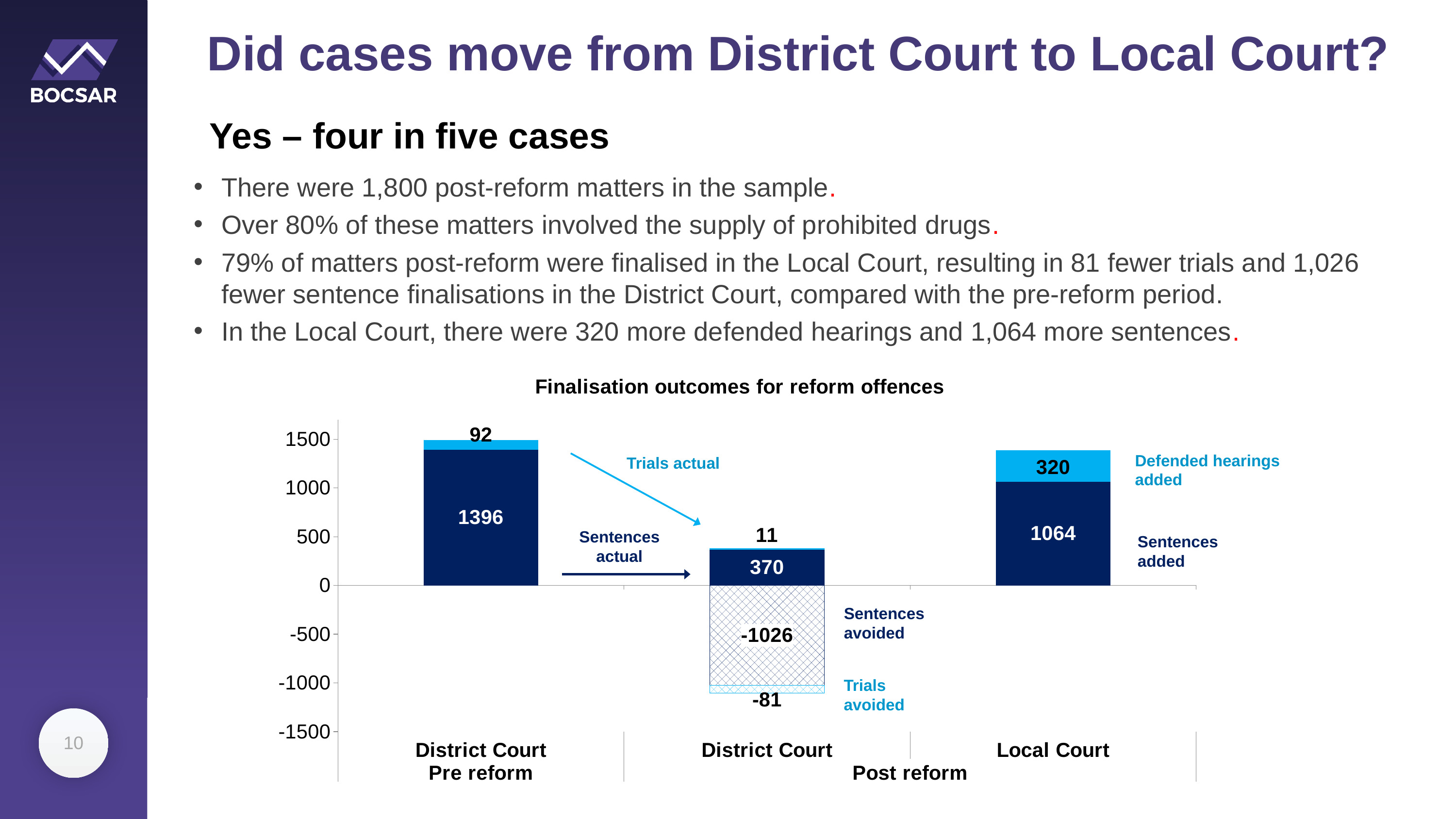
What is the value of sentences actual for District Court Post reform? 370 How many categories are shown on the x axis of the chart? 3 What is the value of defended hearings added for Local Court Post reform? 320 What is the value of sentences actual for District Court Pre reform? 1396 What is the value of trials avoided for District Court Post reform? -81 What is the title of the chart? Finalisation outcomes for reform offences What is the value of trials actual for District Court Pre reform? 92 What is the total of the positive stacked bar for District Court Pre reform? 1488 What is the value of sentences avoided for District Court Post reform? -1026 What is the total of the positive stacked bar for Local Court Post reform? 1384 What kind of chart is shown on the slide? Stacked bar chart Which is larger: sentences actual for District Court Pre reform or sentences added for Local Court Post reform? District Court Pre reform